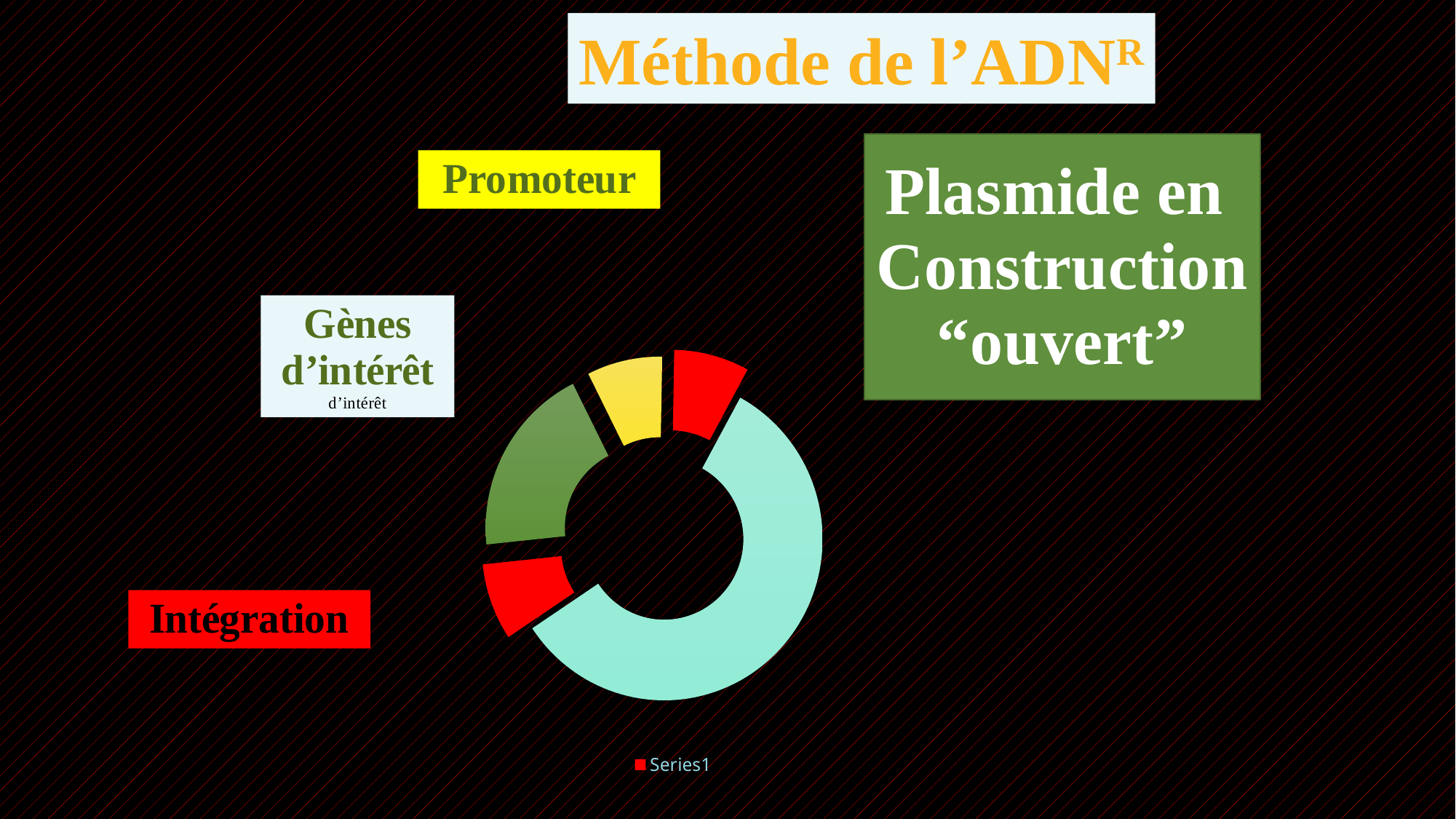
How many series does the chart legend list? 1 What is the name of the series shown in the chart legend? Series1 How many slices does the doughnut chart have? 5 What kind of chart is shown on the slide? Doughnut chart Which colour slice is the largest in the doughnut chart? Light teal How many red slices are there in the doughnut chart? 2 Which is larger in the doughnut chart, the yellow slice or the light teal slice? The light teal slice Which is larger in the doughnut chart, the dark green slice or the yellow slice? The dark green slice